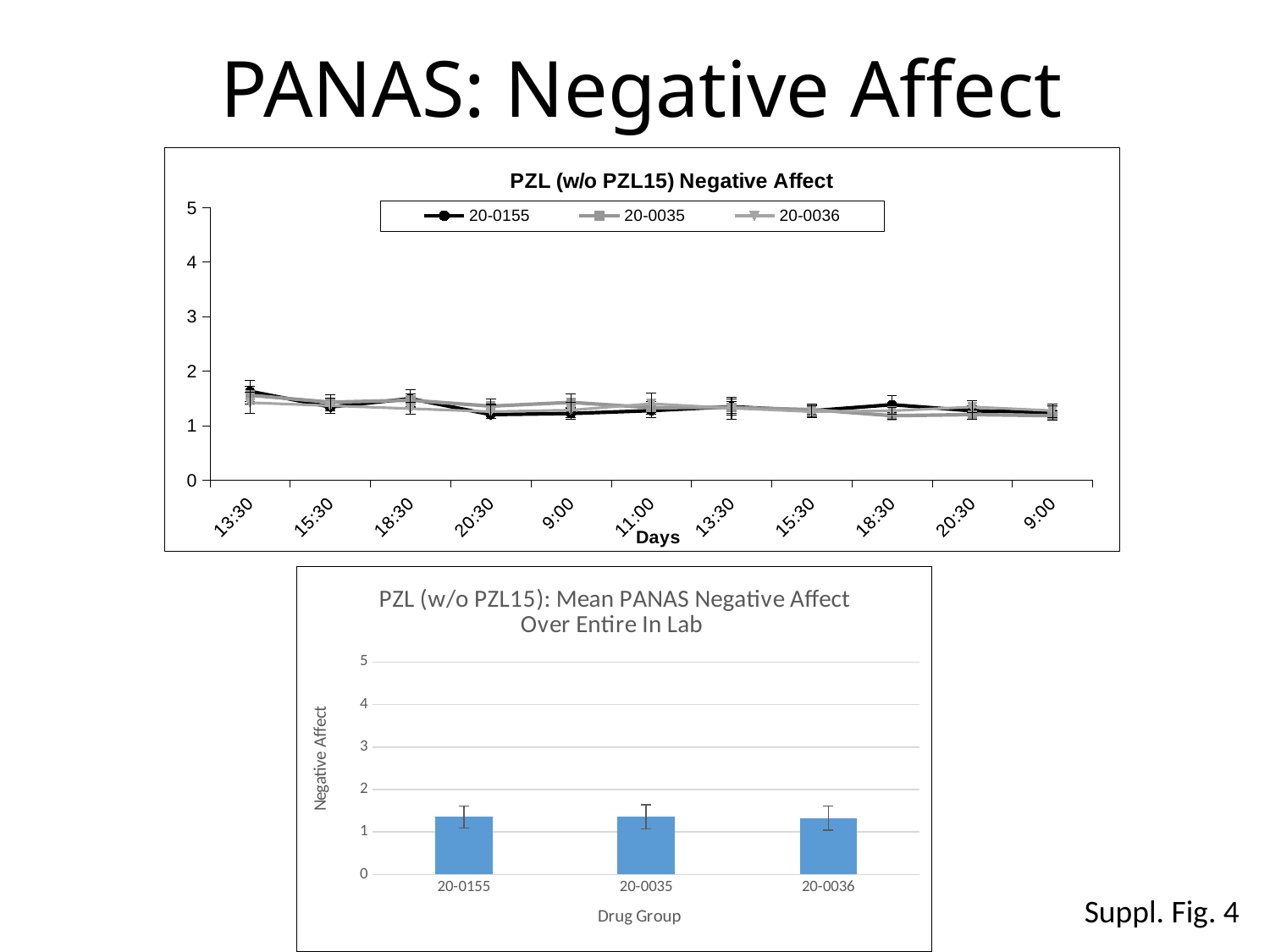
What kind of chart is the bottom chart titled "PZL (w/o PZL15): Mean PANAS Negative Affect Over Entire In Lab"? bar chart In the top chart "PZL (w/o PZL15) Negative Affect", is the value for 20-0155 at the first 13:30 time point greater or less than 1? greater In the top chart "PZL (w/o PZL15) Negative Affect", is the value for 20-0036 at the last 9:00 time point greater or less than 2? less In the top chart "PZL (w/o PZL15) Negative Affect", how many series does the legend list? 3 In the bottom chart "PZL (w/o PZL15): Mean PANAS Negative Affect Over Entire In Lab", how many drug groups are shown? 3 In the bottom chart "PZL (w/o PZL15): Mean PANAS Negative Affect Over Entire In Lab", is the value for 20-0155 greater or less than 2? less What kind of chart is the top chart titled "PZL (w/o PZL15) Negative Affect"? line chart What is the x-axis label of the top chart "PZL (w/o PZL15) Negative Affect"? Days In the top chart "PZL (w/o PZL15) Negative Affect", how many time points are shown along the x axis? 11 What is the x-axis label of the bottom chart "PZL (w/o PZL15): Mean PANAS Negative Affect Over Entire In Lab"? Drug Group